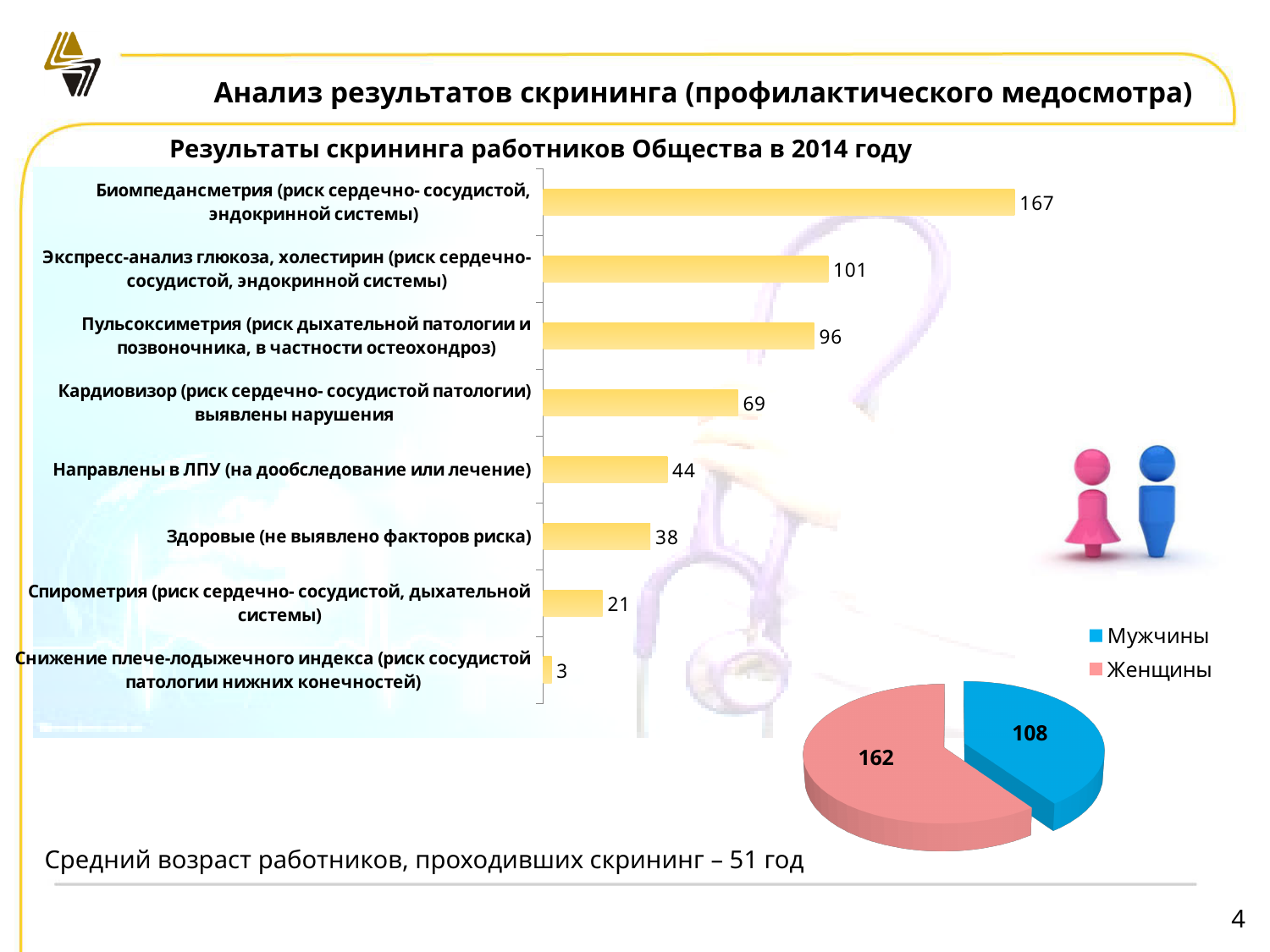
In the bar chart 'Результаты скрининга работников Общества в 2014 году', which is larger: the value for 'Кардиовизор (риск сердечно- сосудистой патологии) выявлены нарушения' or for 'Спирометрия (риск сердечно- сосудистой, дыхательной системы)'? Кардиовизор (риск сердечно- сосудистой патологии) выявлены нарушения What kind of chart is 'Результаты скрининга работников Общества в 2014 году'? Bar chart In the pie chart at the bottom right, what is the value for 'Мужчины'? 108 In the bar chart 'Результаты скрининга работников Общества в 2014 году', which category has the lowest value? Снижение плече-лодыжечного индекса (риск сосудистой патологии нижних конечностей) In the bar chart 'Результаты скрининга работников Общества в 2014 году', which category has the highest value? Биомпедансметрия (риск сердечно- сосудистой, эндокринной системы) In the bar chart 'Результаты скрининга работников Общества в 2014 году', what is the value for 'Биомпедансметрия (риск сердечно- сосудистой, эндокринной системы)'? 167 In the pie chart at the bottom right, what is the value for 'Женщины'? 162 How many entries does the legend of the pie chart at the bottom right list? 2 In the bar chart 'Результаты скрининга работников Общества в 2014 году', what is the value for 'Здоровые (не выявлено факторов риска)'? 38 How many categories does the bar chart 'Результаты скрининга работников Общества в 2014 году' show? 8 In the bar chart 'Результаты скрининга работников Общества в 2014 году', what is the value for 'Направлены в ЛПУ (на дообследование или лечение)'? 44 In the bar chart 'Результаты скрининга работников Общества в 2014 году', what is the difference between the values for 'Экспресс-анализ глюкоза, холестирин' and 'Пульсоксиметрия'? 5